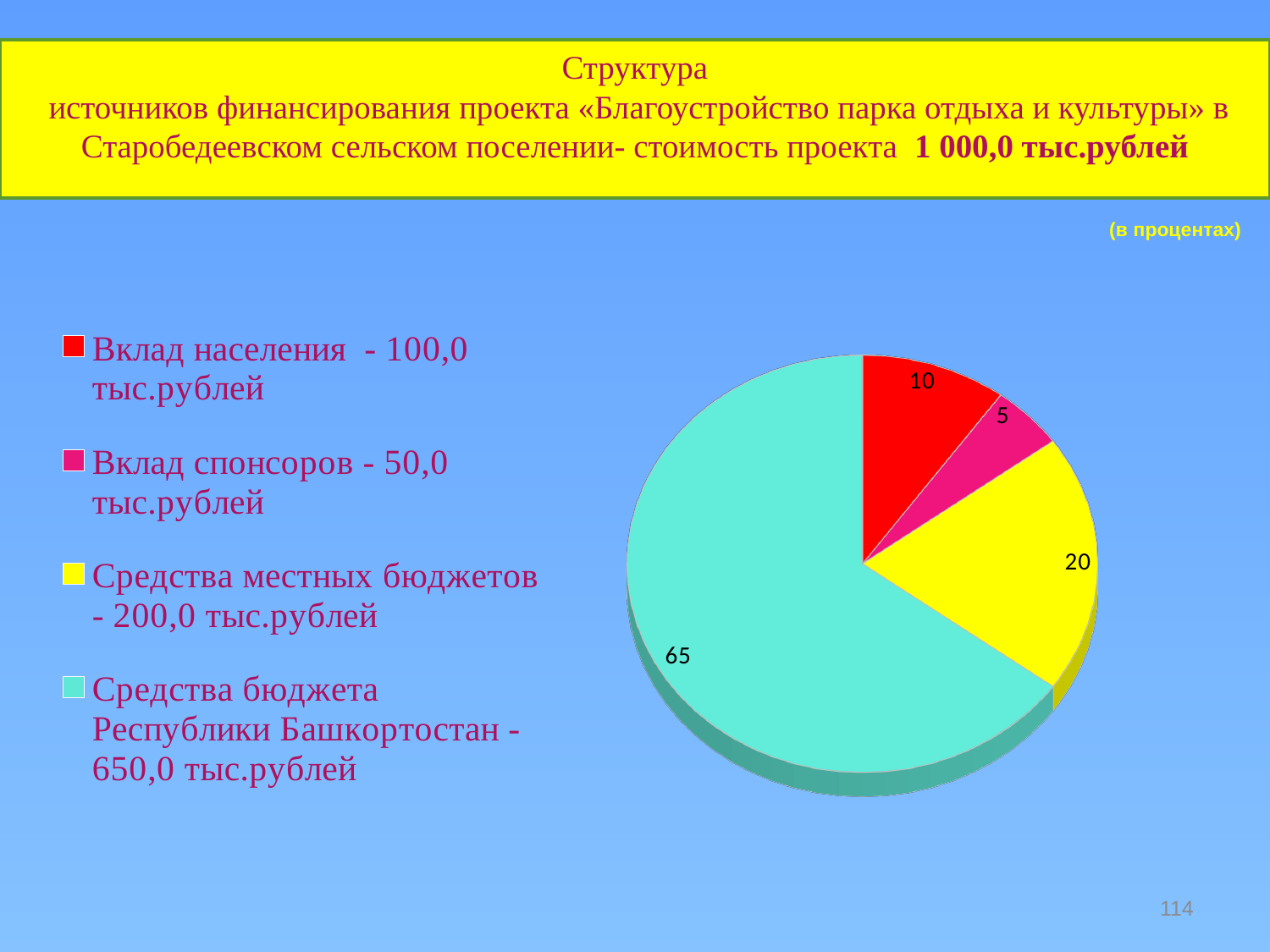
How many entries does the legend list? 4 How many slices does the pie chart have? 4 Which funding source has the smallest share of the pie? Вклад спонсоров - 50,0 тыс.рублей Which slice is larger: "Вклад населения" or "Вклад спонсоров"? Вклад населения What percentage is shown for the slice "Вклад спонсоров - 50,0 тыс.рублей"? 5 Which funding source has the largest share of the pie? Средства бюджета Республики Башкортостан - 650,0 тыс.рублей What is the difference in percentage points between the "Средства местных бюджетов" slice and the "Вклад населения" slice? 10 What percentage is shown for the slice "Средства бюджета Республики Башкортостан - 650,0 тыс.рублей"? 65 What percentage is shown for the slice "Средства местных бюджетов - 200,0 тыс.рублей"? 20 What kind of chart is shown on the slide? pie chart What percentage is shown for the slice "Вклад населения - 100,0 тыс.рублей"? 10 What colour is the slice for "Средства местных бюджетов"? yellow